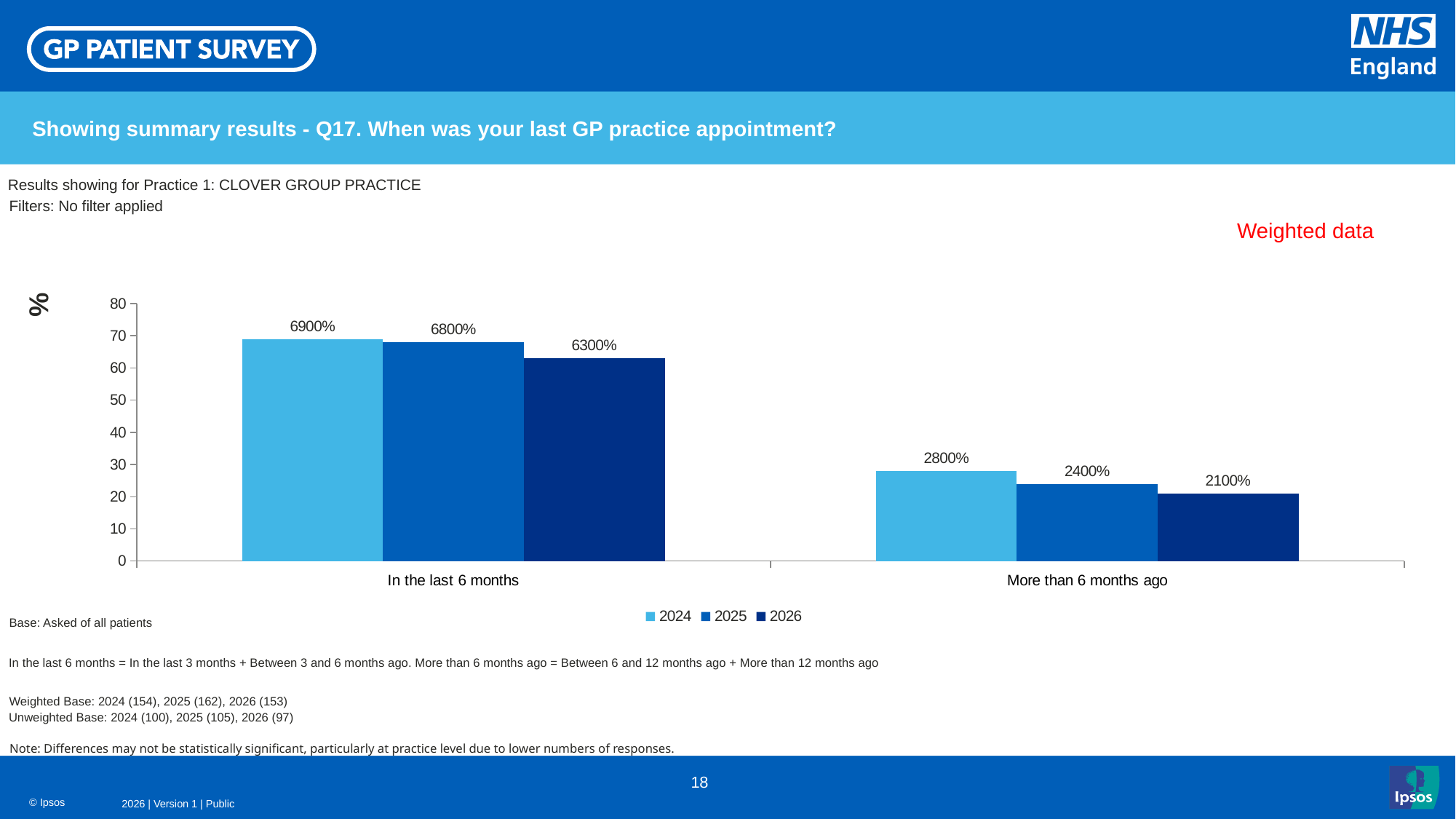
What kind of chart is shown on the slide? Bar chart What is the data label for 2024 in the 'In the last 6 months' category? 6900% What is the data label for 2026 in the 'More than 6 months ago' category? 2100% What is the data label for 2025 in the 'In the last 6 months' category? 6800% Do the bars for 'In the last 6 months' rise or fall from 2024 to 2026? Fall How many series does the legend list? 3 Which year has the lowest bar in the 'In the last 6 months' category? 2026 Which years are listed in the chart legend? 2024, 2025, 2026 Is the 2024 bar for 'In the last 6 months' taller than the 2026 bar for 'In the last 6 months'? Yes Which year has the highest bar in the 'More than 6 months ago' category? 2024 How many categories are shown on the x axis? 2 Is the 2025 bar for 'More than 6 months ago' above or below the 30 mark on the axis? below